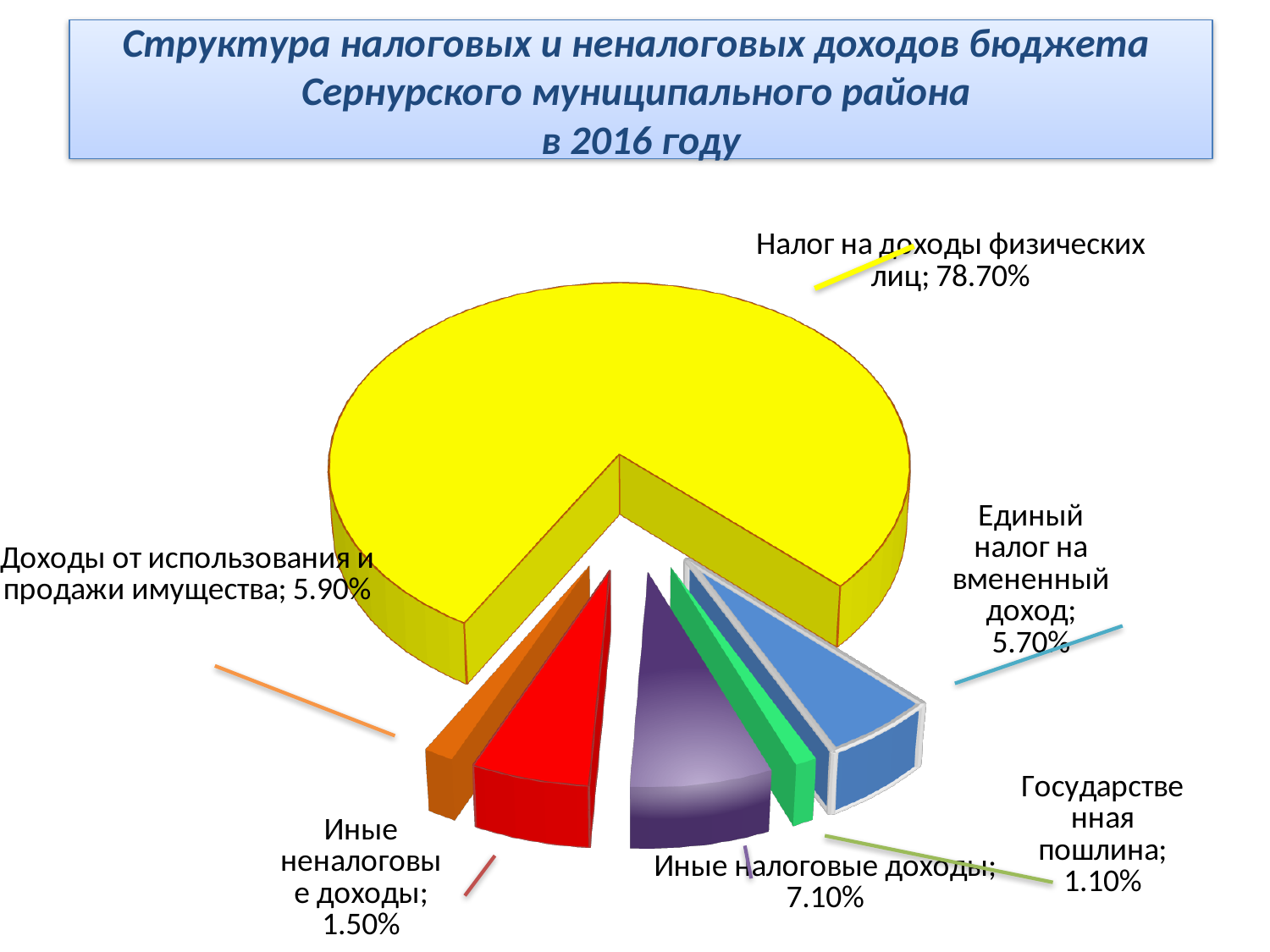
What type of chart is shown on the slide? Pie chart Which category has the largest share of the pie? Налог на доходы физических лиц Which is larger: Иные неналоговые доходы or Государственная пошлина? Иные неналоговые доходы What is the value shown for Иные налоговые доходы? 7.10% What is the difference between the shares of Иные налоговые доходы and Единый налог на вмененный доход? 1.40% What is the value shown for Единый налог на вмененный доход? 5.70% What colour is the slice for Налог на доходы физических лиц? Yellow How many slices does the pie chart have? 6 Which category has the smallest share of the pie? Государственная пошлина What is the value shown for Государственная пошлина? 1.10% What share of the pie does Налог на доходы физических лиц represent? 78.70% What is the value shown for Доходы от использования и продажи имущества? 5.90%